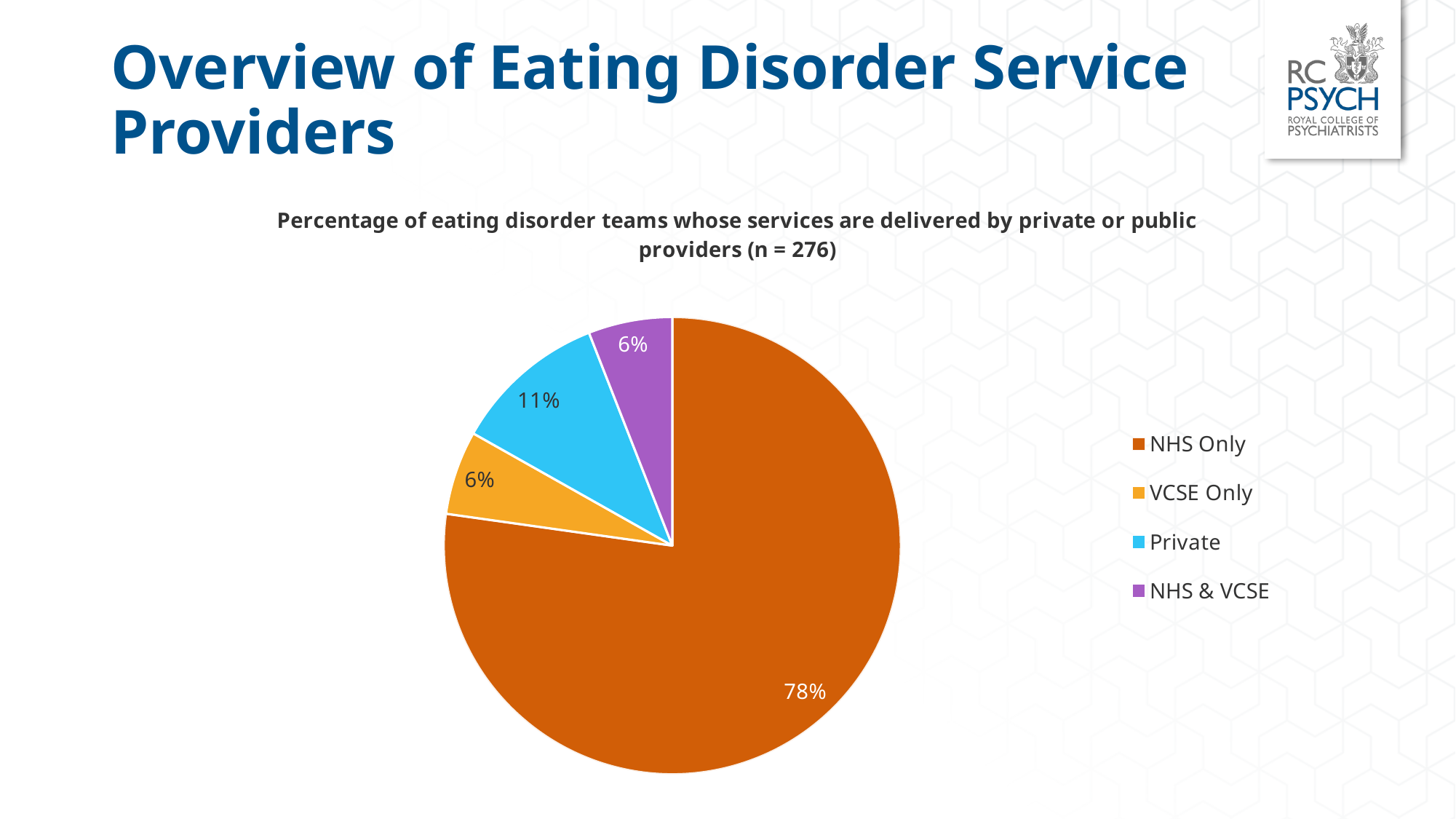
How many categories does the legend list? 4 What percentage of eating disorder teams have services delivered by NHS & VCSE? 6% What is the difference in percentage points between NHS Only and Private? 67 What percentage of eating disorder teams have services delivered by Private providers? 11% What is the sample size (n) stated in the chart title? 276 What colour is the NHS & VCSE slice? purple What percentage of eating disorder teams have services delivered by VCSE Only? 6% What type of chart is shown on the slide? pie chart Which is larger, the share for Private or the share for VCSE Only? Private What percentage of eating disorder teams have services delivered by NHS Only? 78% What is the combined percentage of VCSE Only and NHS & VCSE? 12% Which provider category has the largest share of the pie? NHS Only